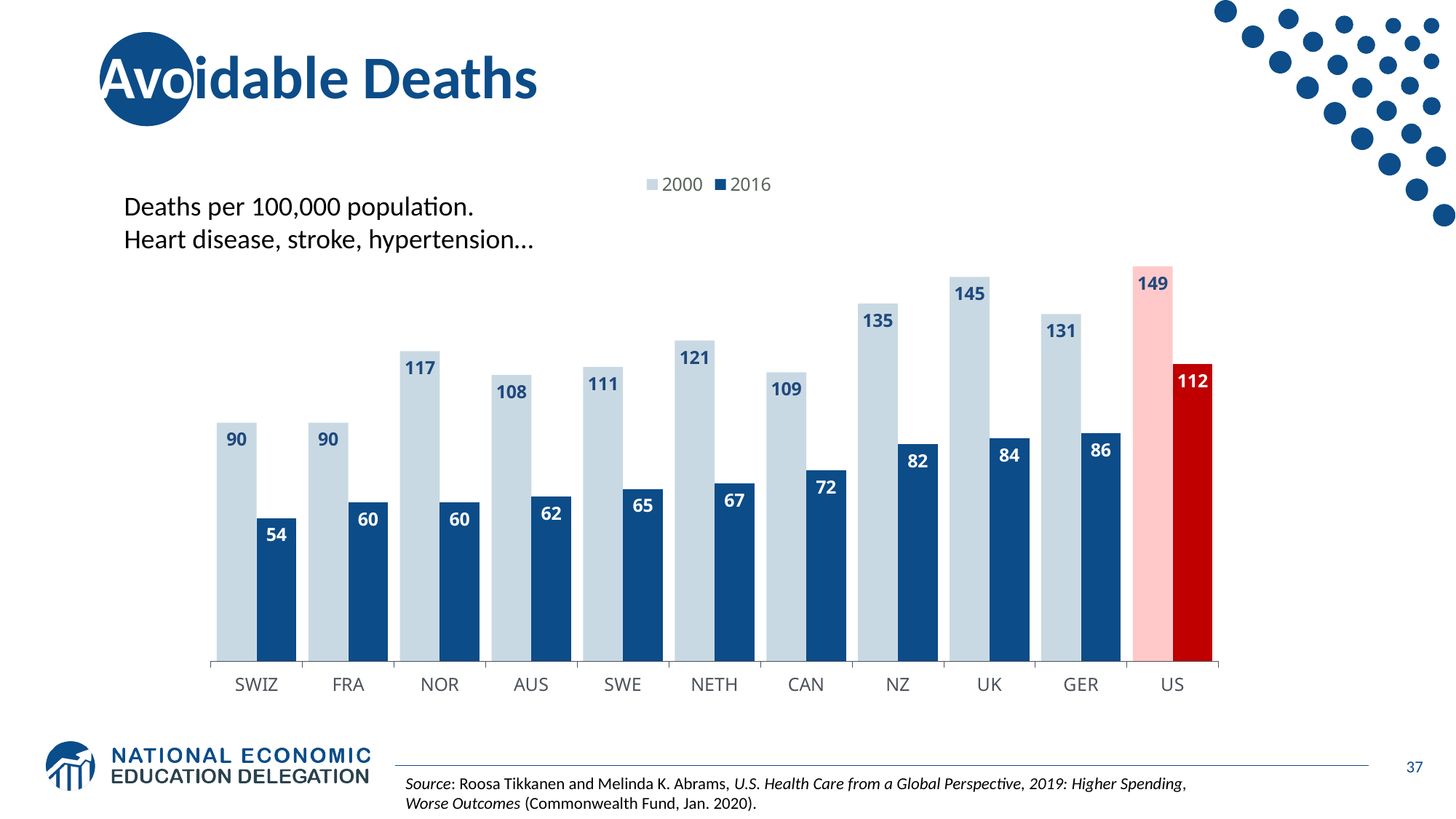
How many series does the legend list? 2 Which country has the highest 2000 value? US What is the 2016 value for the US? 112 What is the difference between the 2000 and 2016 values for the UK? 61 What is the 2016 value for SWIZ? 54 What kind of chart is shown on the slide? Bar chart Which country's bars are highlighted in red/pink rather than blue? US Which is larger, the 2016 value for GER or the 2016 value for NZ? GER What are the two series listed in the legend? 2000 and 2016 Which country has the lowest 2016 value? SWIZ How many countries are shown on the x axis? 11 What is the 2000 value for NOR? 117